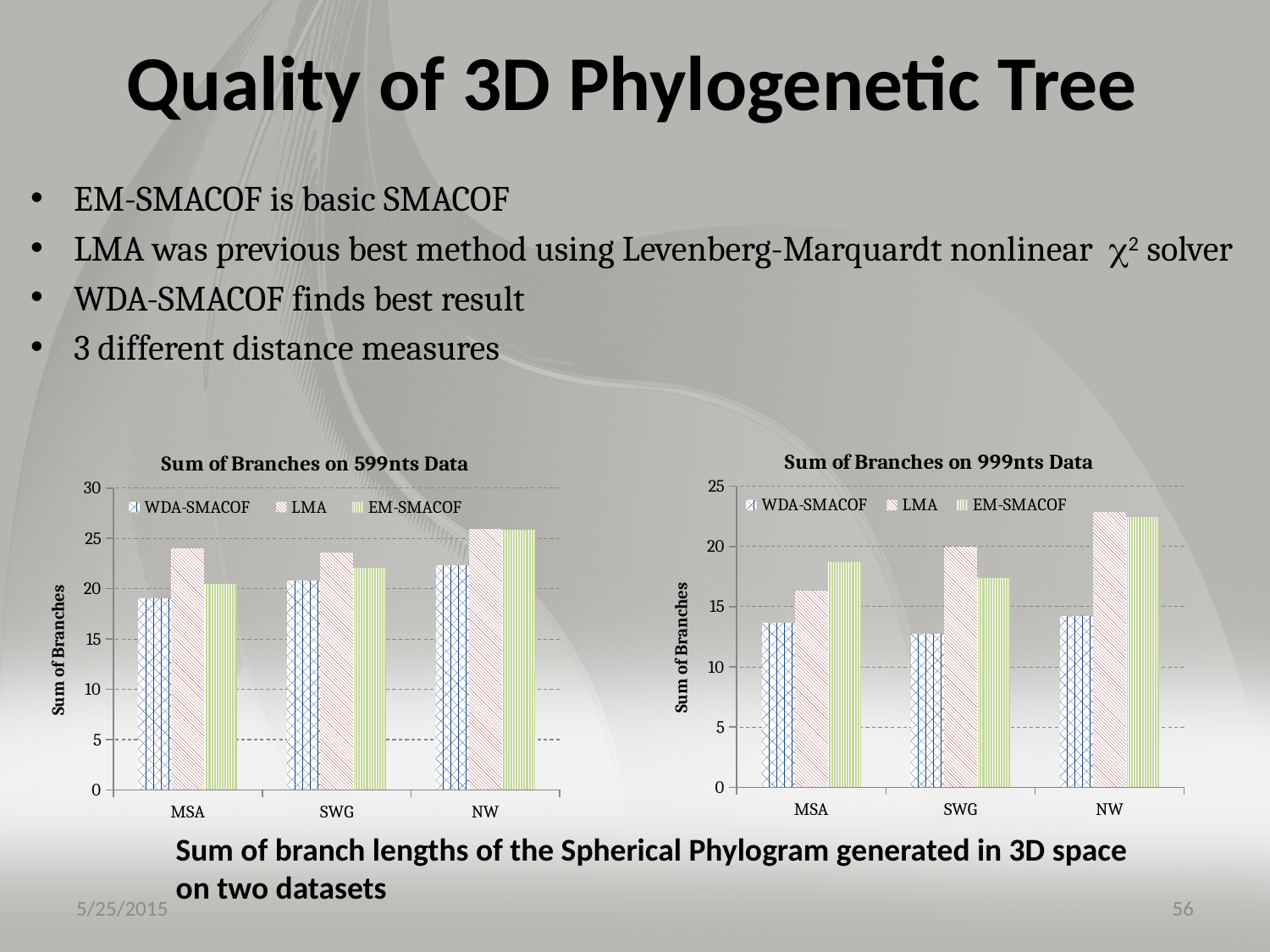
In the 'Sum of Branches on 999nts Data' chart, is the LMA value for NW greater or less than 20? greater In the 'Sum of Branches on 599nts Data' chart, is the LMA value for NW greater or less than 25? greater In the 'Sum of Branches on 599nts Data' chart, is the WDA-SMACOF value for MSA greater or less than 20? less In the 'Sum of Branches on 599nts Data' chart, which is larger for MSA: LMA or WDA-SMACOF? LMA How many categories are shown on the x axis of the 'Sum of Branches on 999nts Data' chart? 3 How many series does the legend of the 'Sum of Branches on 599nts Data' chart list? 3 In the 'Sum of Branches on 999nts Data' chart, which series has the lowest value for NW? WDA-SMACOF In the 'Sum of Branches on 599nts Data' chart, which category has the highest LMA value? NW In the 'Sum of Branches on 999nts Data' chart, which is larger for SWG: LMA or EM-SMACOF? LMA What is the y-axis label of the chart on the right of the slide? Sum of Branches What kind of chart is the 'Sum of Branches on 599nts Data' chart? bar chart